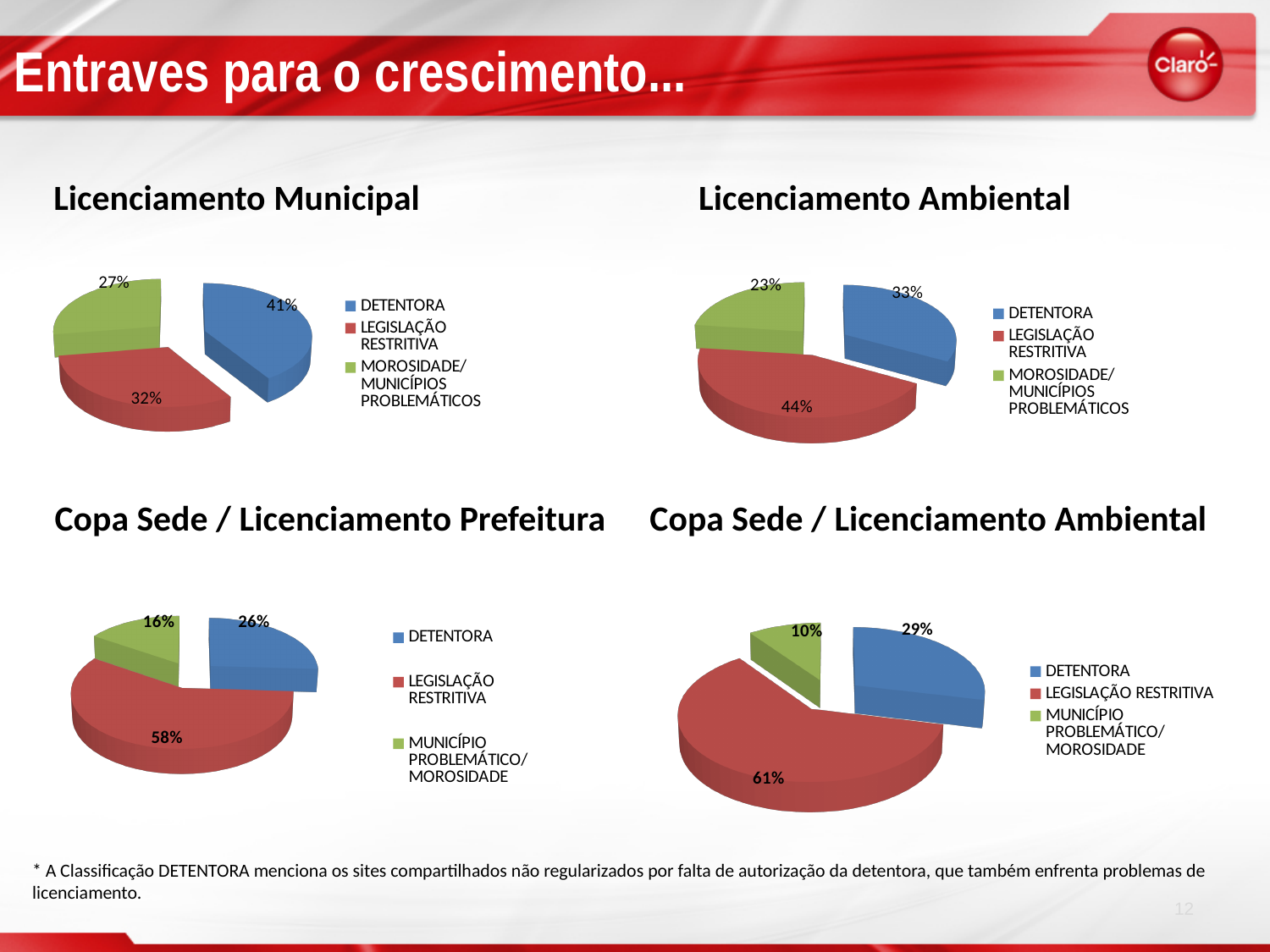
What type of chart is the Copa Sede / Licenciamento Ambiental chart? Pie chart In the Copa Sede / Licenciamento Ambiental chart, what is the difference between the LEGISLAÇÃO RESTRITIVA and DETENTORA shares? 32% In the Copa Sede / Licenciamento Ambiental chart, what share does MUNICÍPIO PROBLEMÁTICO/MOROSIDADE have? 10% In the Licenciamento Municipal chart, which category has the smallest share? MOROSIDADE/MUNICÍPIOS PROBLEMÁTICOS In the Copa Sede / Licenciamento Prefeitura chart, which is larger, DETENTORA or MUNICÍPIO PROBLEMÁTICO/MOROSIDADE? DETENTORA In the Copa Sede / Licenciamento Prefeitura chart, what share does LEGISLAÇÃO RESTRITIVA have? 58% In the Licenciamento Ambiental chart, what is the difference between the DETENTORA and MOROSIDADE/MUNICÍPIOS PROBLEMÁTICOS shares? 10% How many slices does the Licenciamento Municipal chart have? 3 In the Licenciamento Ambiental chart, what share does LEGISLAÇÃO RESTRITIVA have? 44% In the Licenciamento Municipal chart, what colour is the LEGISLAÇÃO RESTRITIVA slice? Red In the Licenciamento Ambiental chart, which category has the largest share? LEGISLAÇÃO RESTRITIVA In the Licenciamento Municipal chart, what share does DETENTORA have? 41%